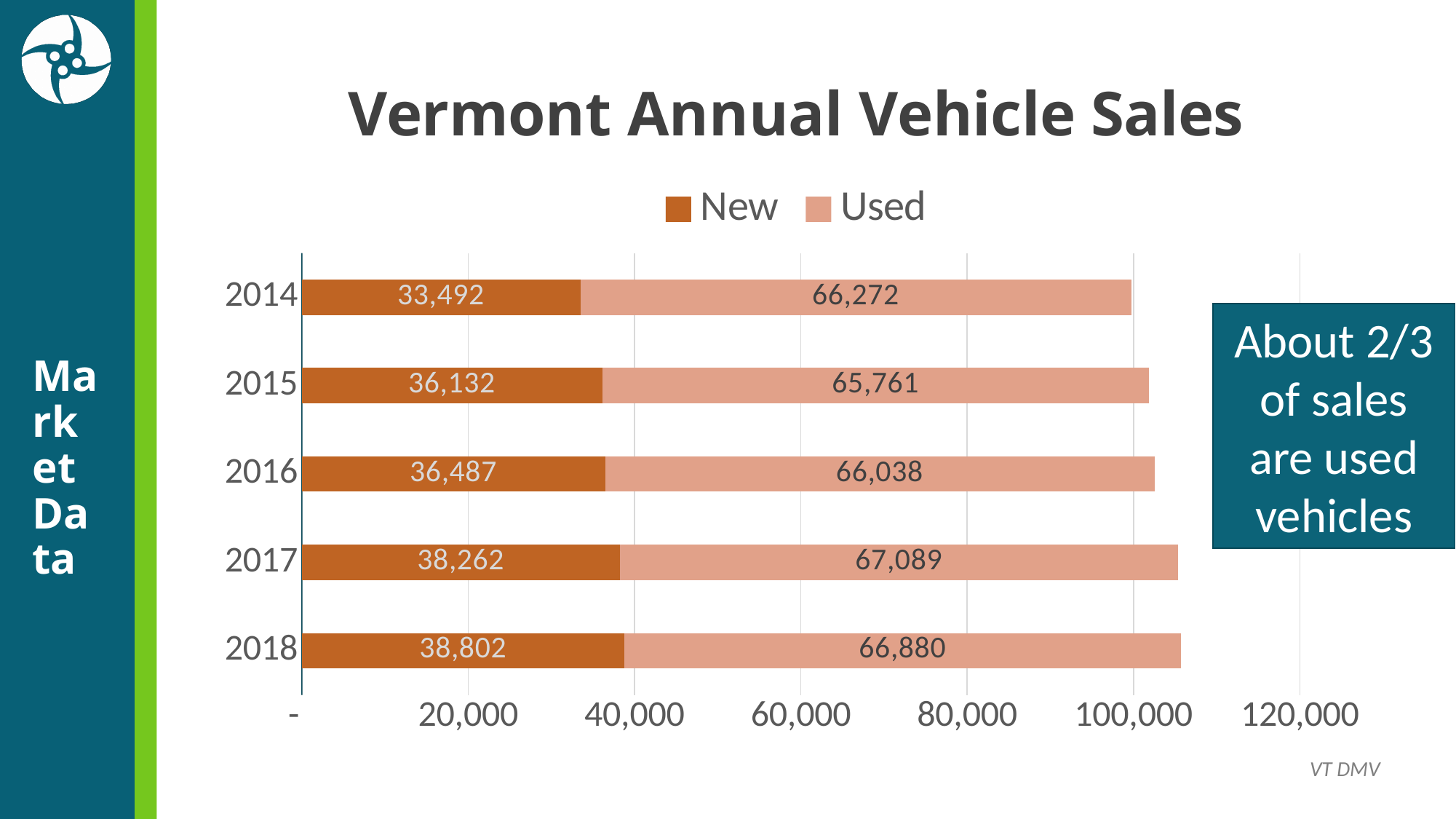
What is the total of the stacked bar for 2014? 99,764 Which year has the lowest New vehicle sales? 2014 What is the value for New vehicle sales in 2016? 36,487 How many years are shown on the chart? 5 What kind of chart is shown on the slide? Stacked bar chart Which is larger: Used vehicle sales in 2014 or in 2018? 2018 Which year has the lowest Used vehicle sales? 2015 How many series does the legend list? 2 Which year has the highest New vehicle sales? 2018 What is the difference between New vehicle sales in 2018 and in 2014? 5,310 What is the total of the stacked bar for 2018? 105,682 What is the value for Used vehicle sales in 2017? 67,089